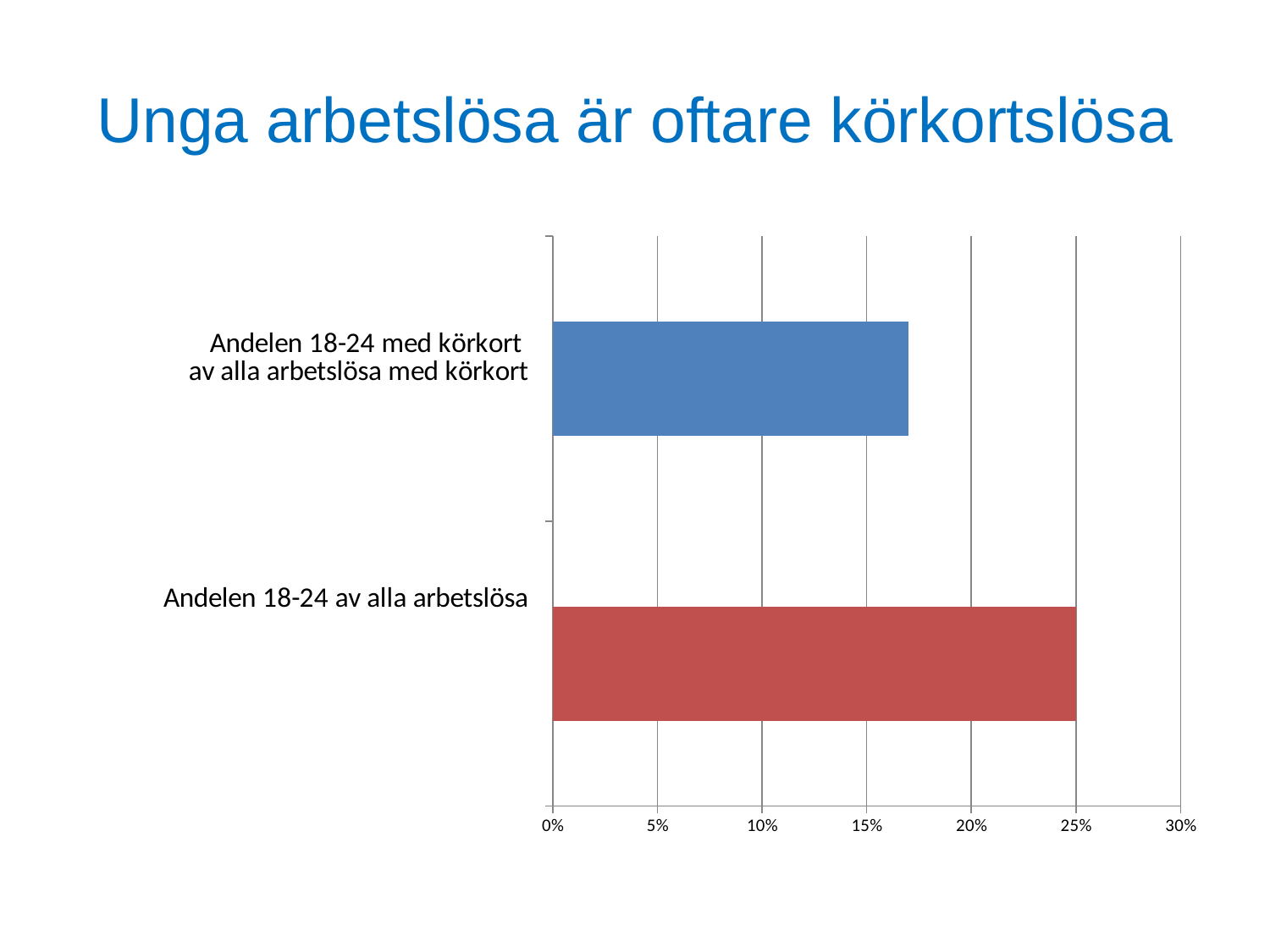
What is the value for 'Andelen 18-24 av alla arbetslösa'? 25% Which category has the lowest value? Andelen 18-24 med körkort av alla arbetslösa med körkort What is the title of the slide? Unga arbetslösa är oftare körkortslösa Is the value for 'Andelen 18-24 med körkort av alla arbetslösa med körkort' greater or less than 20%? less Is the value for 'Andelen 18-24 med körkort av alla arbetslösa med körkort' greater or less than 15%? greater Which category has the highest value? Andelen 18-24 av alla arbetslösa What colour is the bar for 'Andelen 18-24 av alla arbetslösa'? red Is the value for 'Andelen 18-24 av alla arbetslösa' greater or less than 20%? greater How many categories (bars) does the chart show? 2 What kind of chart is shown on the slide? bar chart Which is larger: the value for 'Andelen 18-24 av alla arbetslösa' or the value for 'Andelen 18-24 med körkort av alla arbetslösa med körkort'? Andelen 18-24 av alla arbetslösa